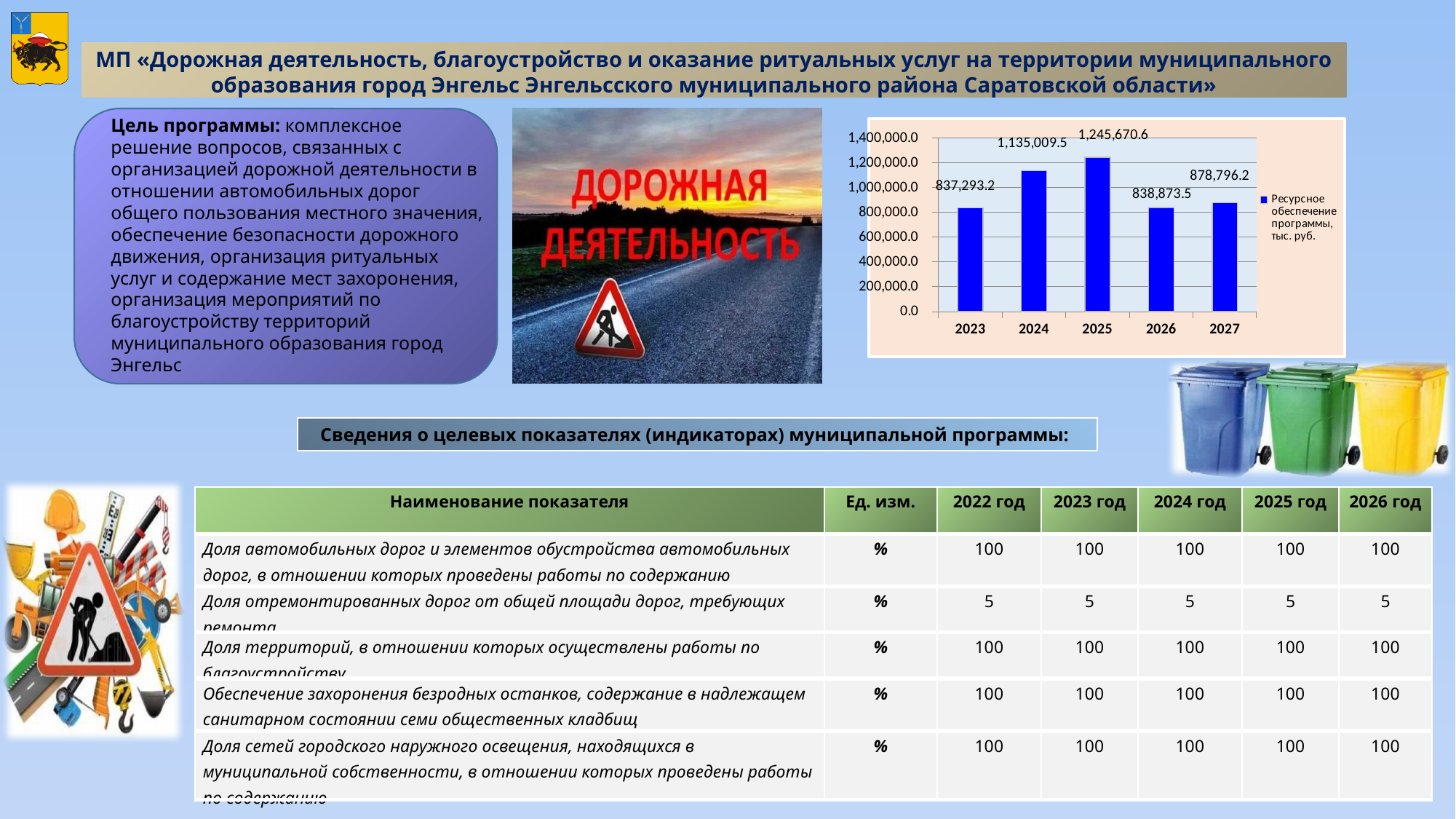
What is the value for 2025 in the bar chart? 1,245,670.6 What is the difference between the values for 2027 and 2026 in the bar chart? 39,922.7 How many series does the legend of the bar chart list? 1 What is the difference between the values for 2025 and 2024 in the bar chart? 110,661.1 What is the value for 2023 in the bar chart? 837,293.2 Is the value for 2027 in the bar chart greater or less than 1,000,000.0? less Do the values in the bar chart rise or fall from 2023 to 2025? rise Which year has the highest value in the bar chart? 2025 Which is larger in the bar chart, the value for 2024 or the value for 2027? 2024 What kind of chart is shown on the slide? bar chart How many years are shown on the x axis of the bar chart? 5 What is the value for 2027 in the bar chart? 878,796.2